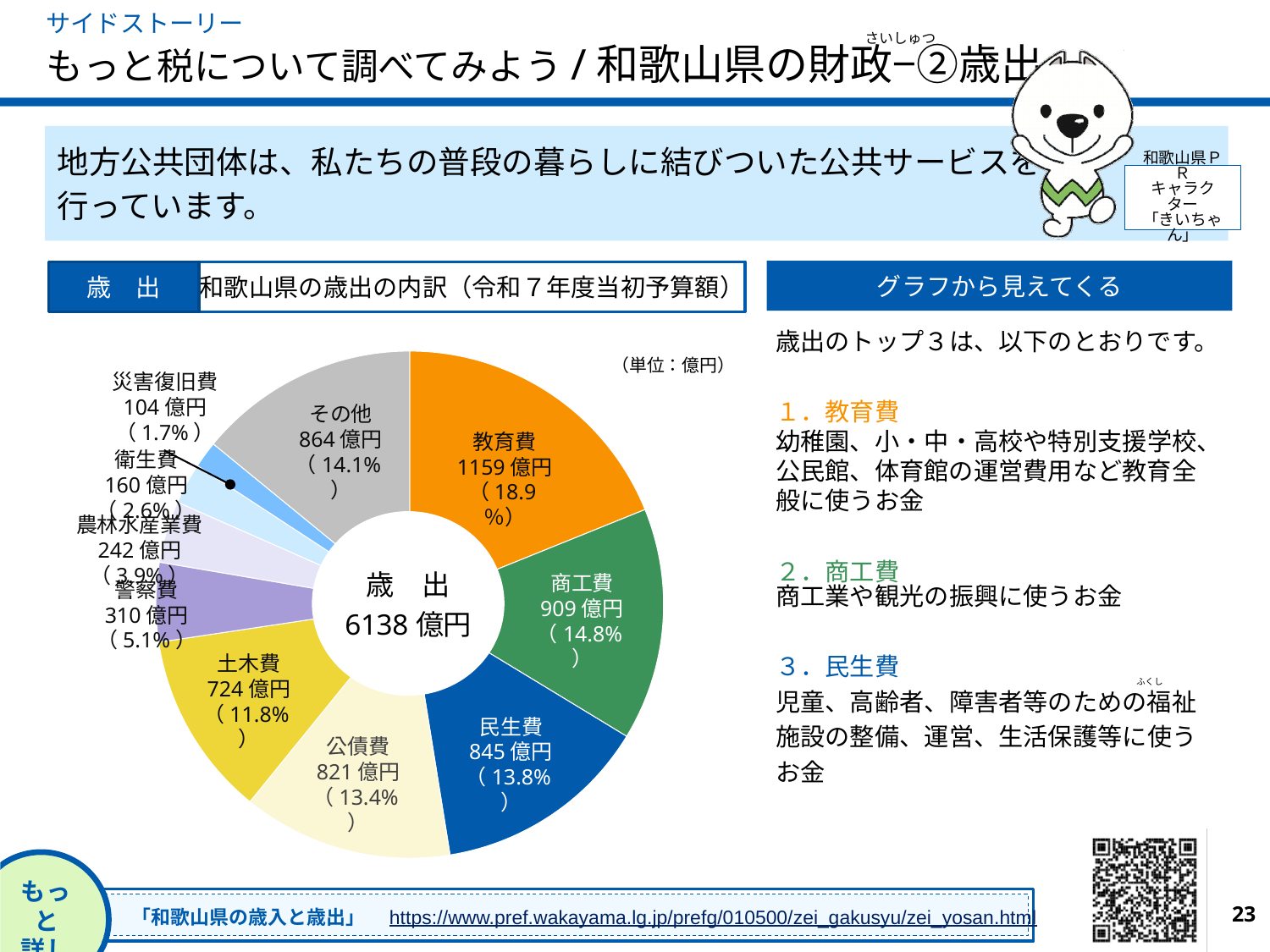
Which is larger, 公債費 or 土木費? 公債費 What percentage share does 警察費 have? 5.1% What is the value shown for 民生費? 845 億円 What percentage share does 商工費 have in the pie chart? 14.8% How many categories are shown in the pie chart? 10 Which category has the largest slice in the pie chart? 教育費 Which category has the smallest slice in the pie chart? 災害復旧費 What is the value shown for 教育費 in the pie chart? 1159 億円 What is the total 歳出 shown in the centre of the chart? 6138 億円 What is the difference in 億円 between 教育費 and 商工費? 250 億円 What unit is stated for the values in the chart? 億円 What kind of chart is shown on the slide? Pie chart